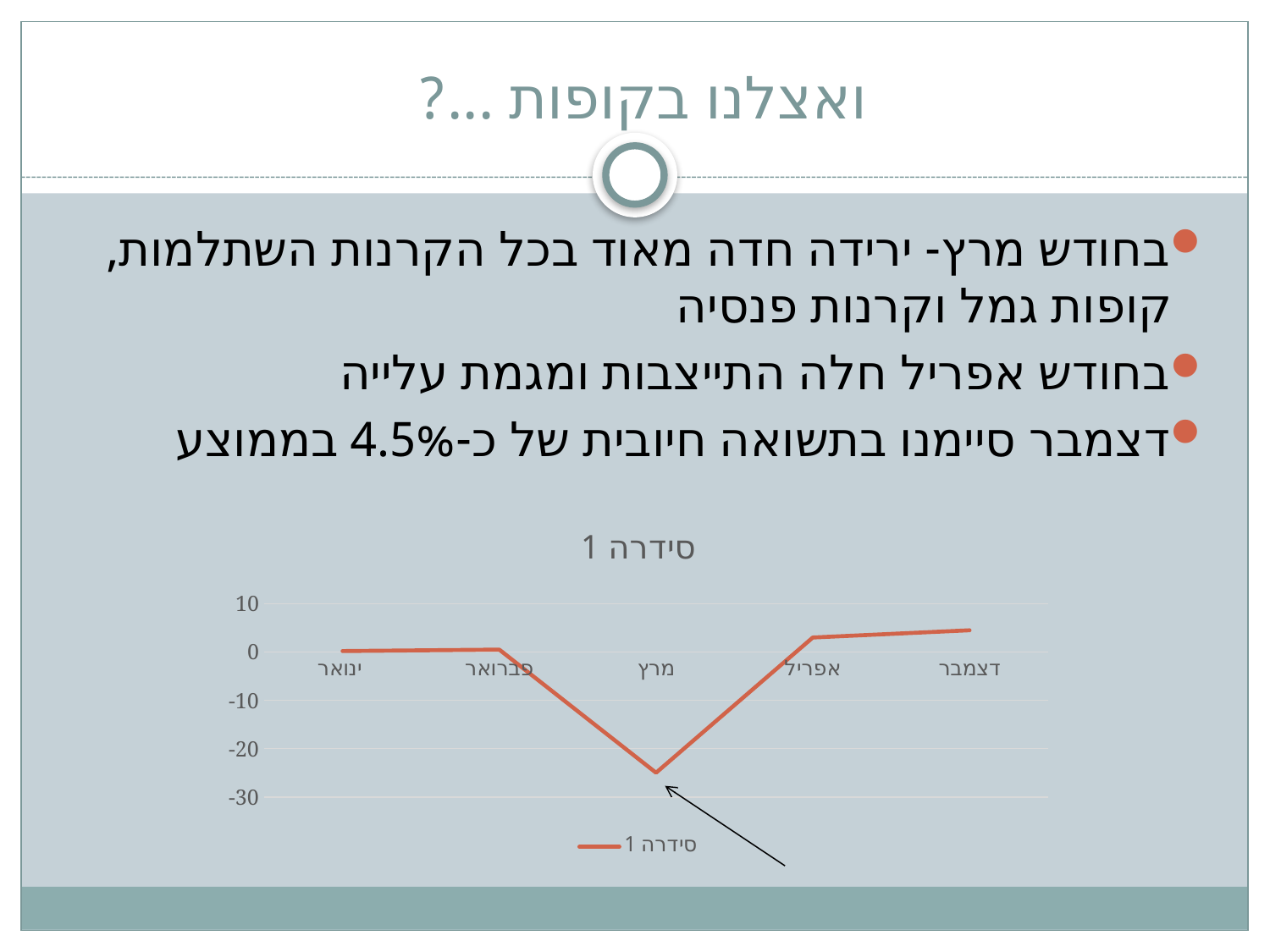
Which is larger, the value for מרץ or the value for אפריל? אפריל How many series does the chart's legend list? 1 Does the line rise or fall from מרץ to דצמבר? rise What kind of chart is shown on the slide? line chart Is the value for דצמבר greater or less than 0? greater Which category has the highest value in the chart? דצמבר Is the value for מרץ greater or less than -30? greater Which category has the lowest value in the chart? מרץ What is the title of the chart? סידרה 1 How many categories are shown on the x axis of the chart? 5 Does the line rise or fall from פברואר to מרץ? fall Is the value for מרץ greater or less than -20? less